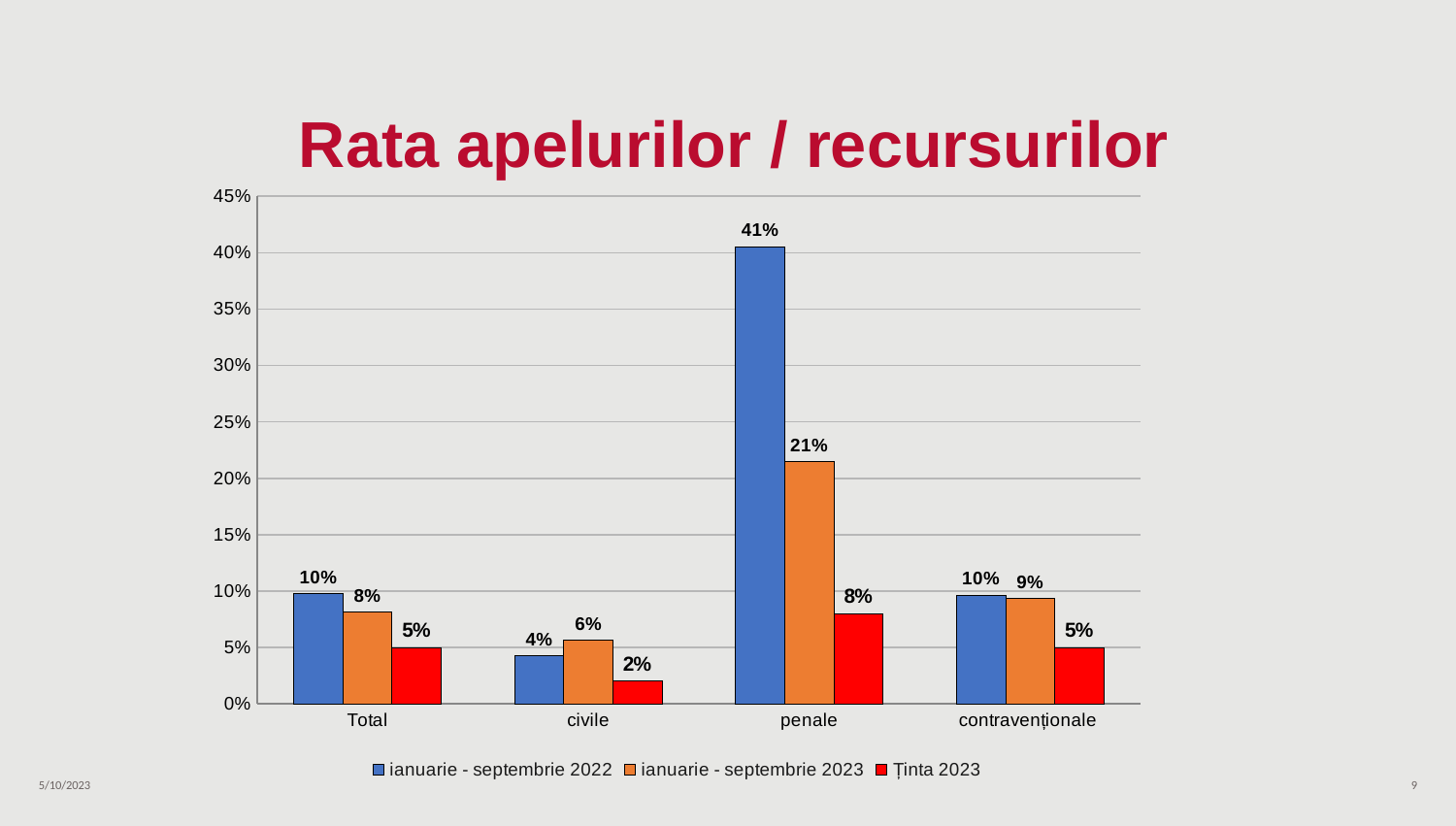
Which category has the lowest value in the Ținta 2023 series? civile How many series does the legend list? 3 How many categories are shown on the x axis? 4 Which category has the highest value in the ianuarie - septembrie 2022 series? penale What is the value for penale in the ianuarie - septembrie 2022 series? 41% What is the Ținta 2023 value for contravenționale? 5% What is the difference between the ianuarie - septembrie 2022 and ianuarie - septembrie 2023 values for penale? 20% What kind of chart is shown on the slide? bar chart What is the value for civile in the ianuarie - septembrie 2023 series? 6% Is the ianuarie - septembrie 2023 value for penale greater or less than 25%? less For civile, which is larger: the ianuarie - septembrie 2022 value or the ianuarie - septembrie 2023 value? ianuarie - septembrie 2023 What is the title of the chart? Rata apelurilor / recursurilor